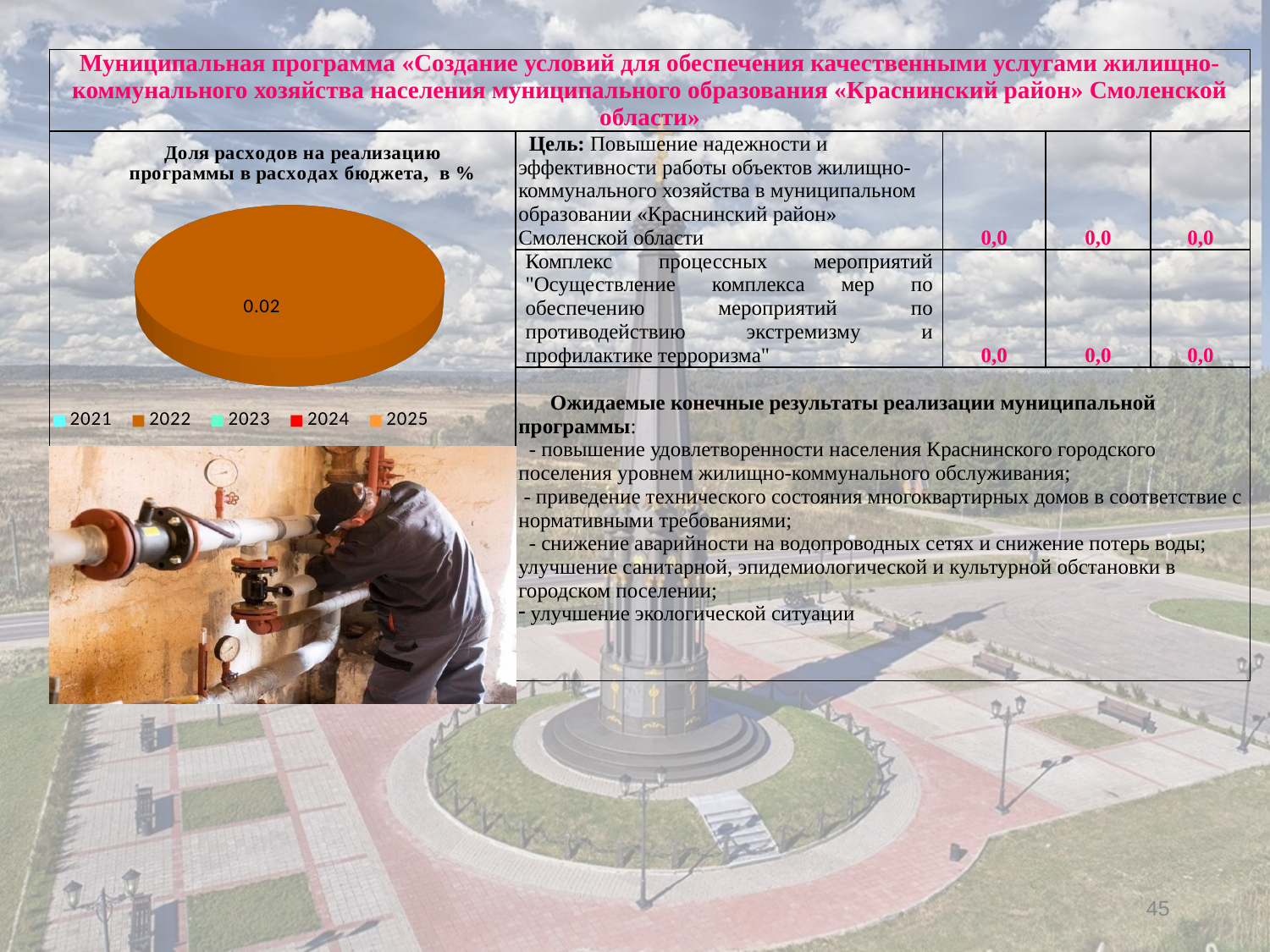
What is the title of the pie chart? Доля расходов на реализацию программы в расходах бюджета, в % What is the value shown for 2022 in the pie chart? 0.02 What value is printed on the pie chart's slice? 0.02 Is the value printed on the pie chart slice greater or less than 1? less Which year in the legend corresponds to the orange slice shown in the pie chart? 2022 Which year's slice makes up the entire pie chart? 2022 What is the first year listed in the pie chart's legend? 2021 What kind of chart is shown on the slide? pie chart How many slices are visible in the pie chart? 1 How many entries does the legend of the pie chart list? 5